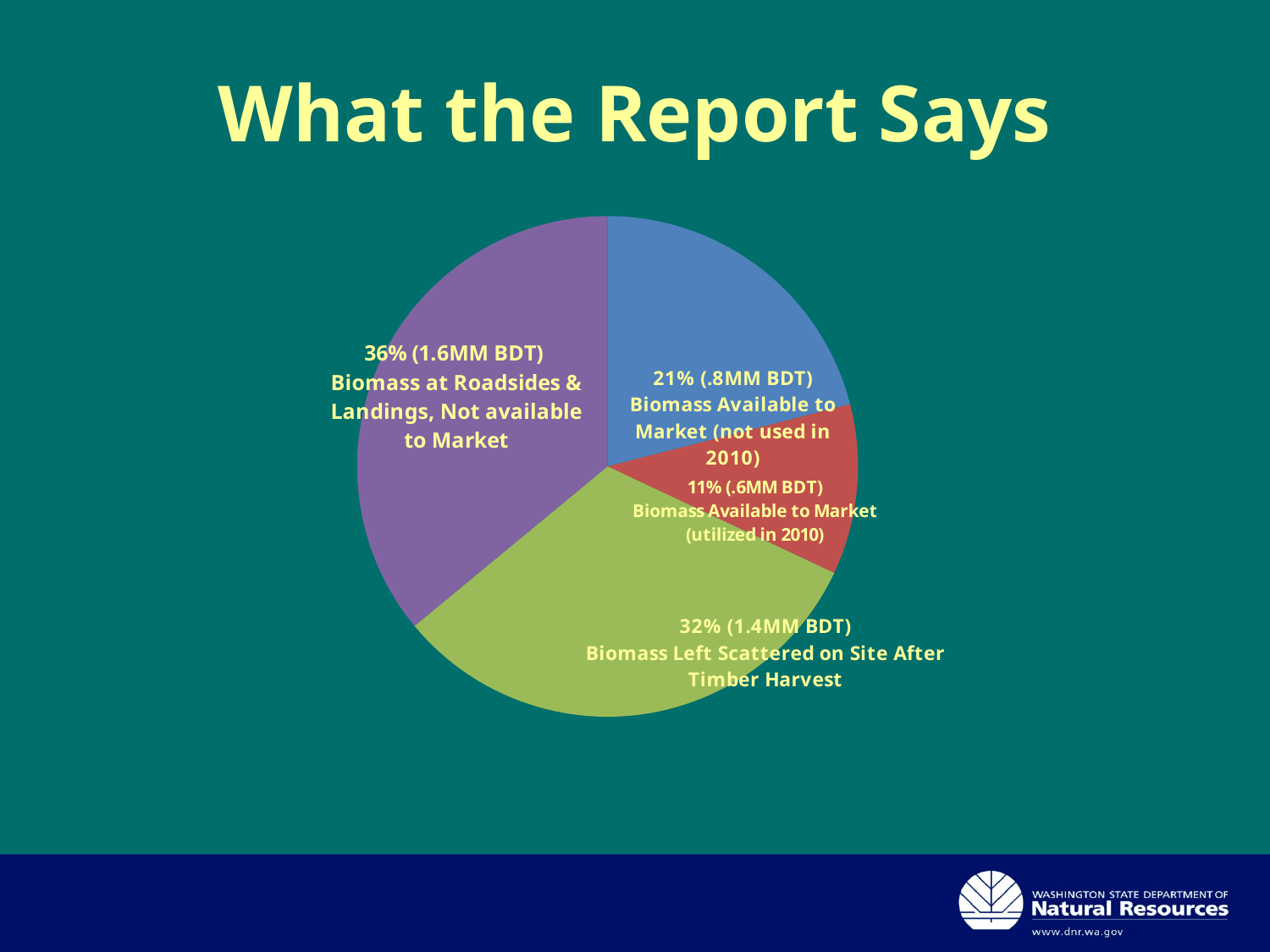
What is the difference in percentage points between Biomass Available to Market (not used in 2010) and Biomass Available to Market (utilized in 2010)? 10 What amount in BDT is shown for Biomass at Roadsides & Landings, Not available to Market? 1.6MM BDT What percentage of the pie is Biomass Available to Market (utilized in 2010)? 11% What percentage of the pie is Biomass at Roadsides & Landings, Not available to Market? 36% How many slices does the pie chart have? 4 What percentage of the pie is Biomass Available to Market (not used in 2010)? 21% What kind of chart is shown on the slide? pie chart Which slice is the smallest in the pie chart? Biomass Available to Market (utilized in 2010) Which slice is the largest in the pie chart? Biomass at Roadsides & Landings, Not available to Market What is the title of the slide containing the pie chart? What the Report Says What amount in BDT is shown for Biomass Available to Market (utilized in 2010)? .6MM BDT